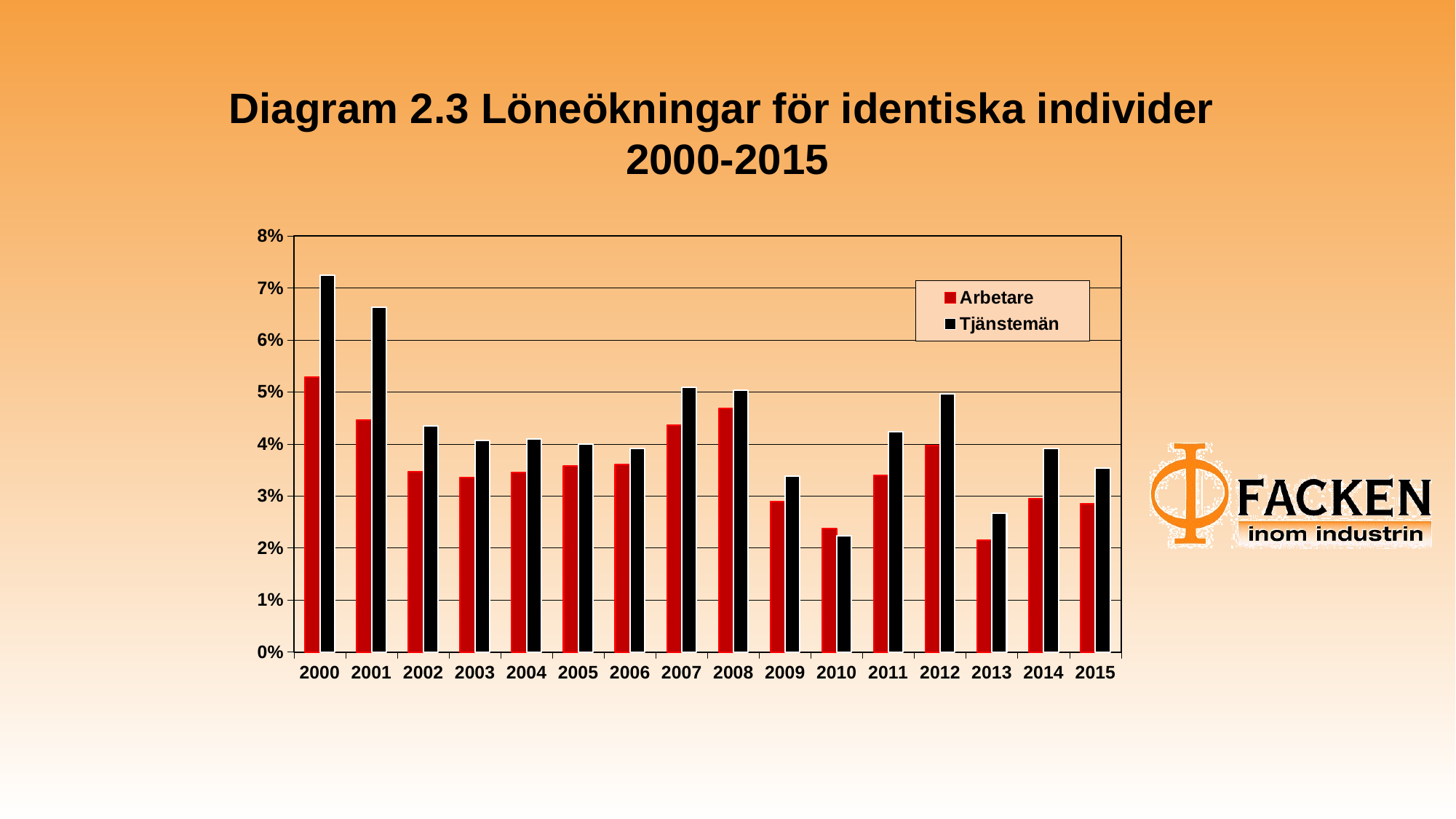
Which colour represents the Arbetare series in the legend? red What kind of chart is shown on the slide? bar chart Is the Arbetare value for 2008 greater or less than 4%? greater How many series does the legend list? 2 Is the Arbetare value for 2013 greater or less than 3%? less In which year is the Arbetare value lowest? 2013 Is the Tjänstemän value for 2000 greater or less than 7%? greater In which year is the Tjänstemän value lowest? 2010 In which year is the Arbetare value highest? 2000 In 2001, which series has the larger value, Arbetare or Tjänstemän? Tjänstemän How many years are shown on the x axis? 16 In which year is the Tjänstemän value highest? 2000